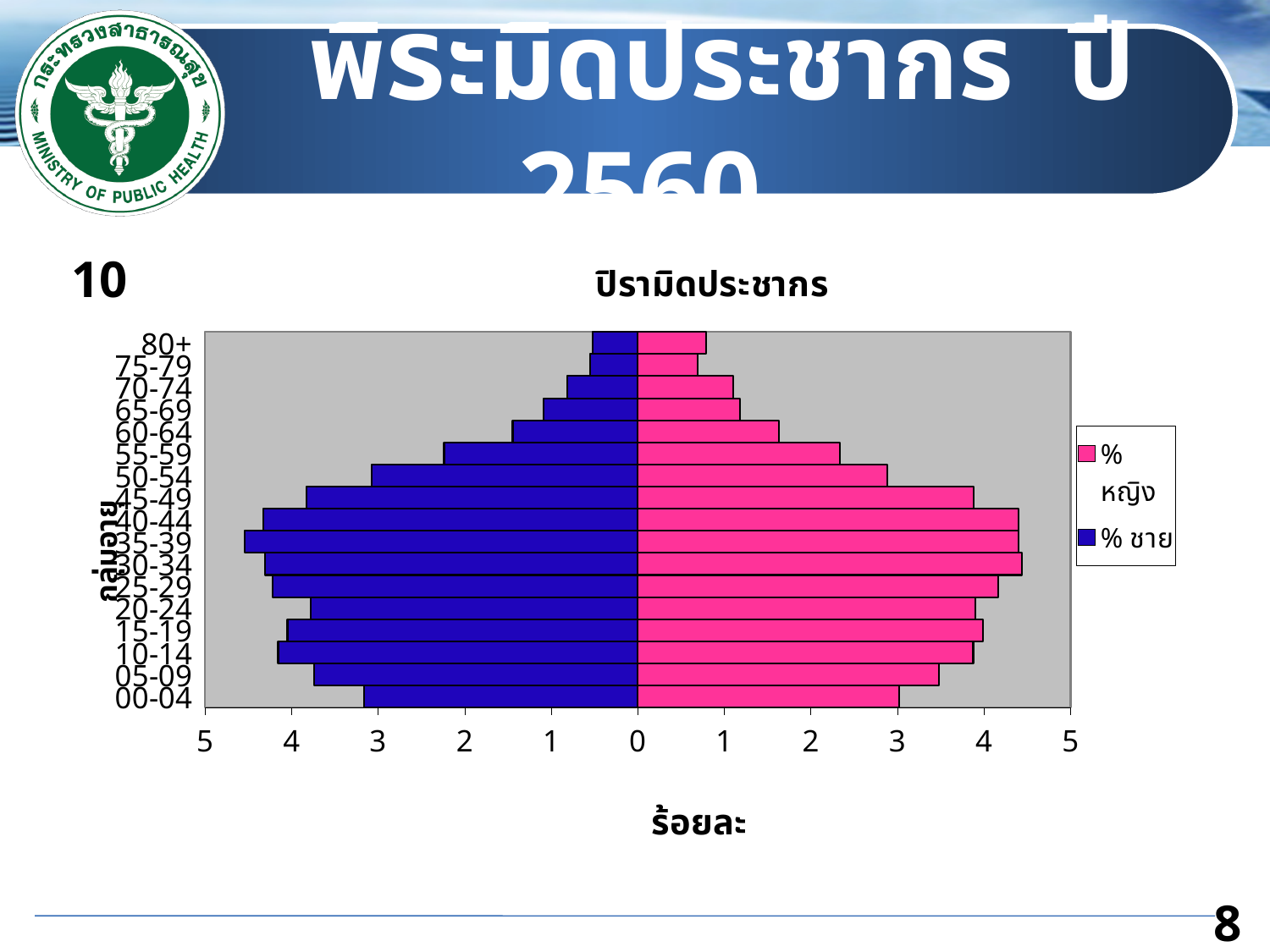
Is the value for % หญิง in the 05-09 age group greater or less than 3? greater Which colour represents % หญิง in the chart? pink Is the value for % ชาย in the 00-04 age group greater or less than 3? greater What kind of chart is shown on the slide? bar chart Is the value for % ชาย in the 70-74 age group greater or less than 1? less Which is larger for % ชาย: the 35-39 age group or the 00-04 age group? 35-39 How many series does the legend list? 2 Which age group has the highest value for % ชาย? 35-39 How many age groups are plotted on the y axis? 17